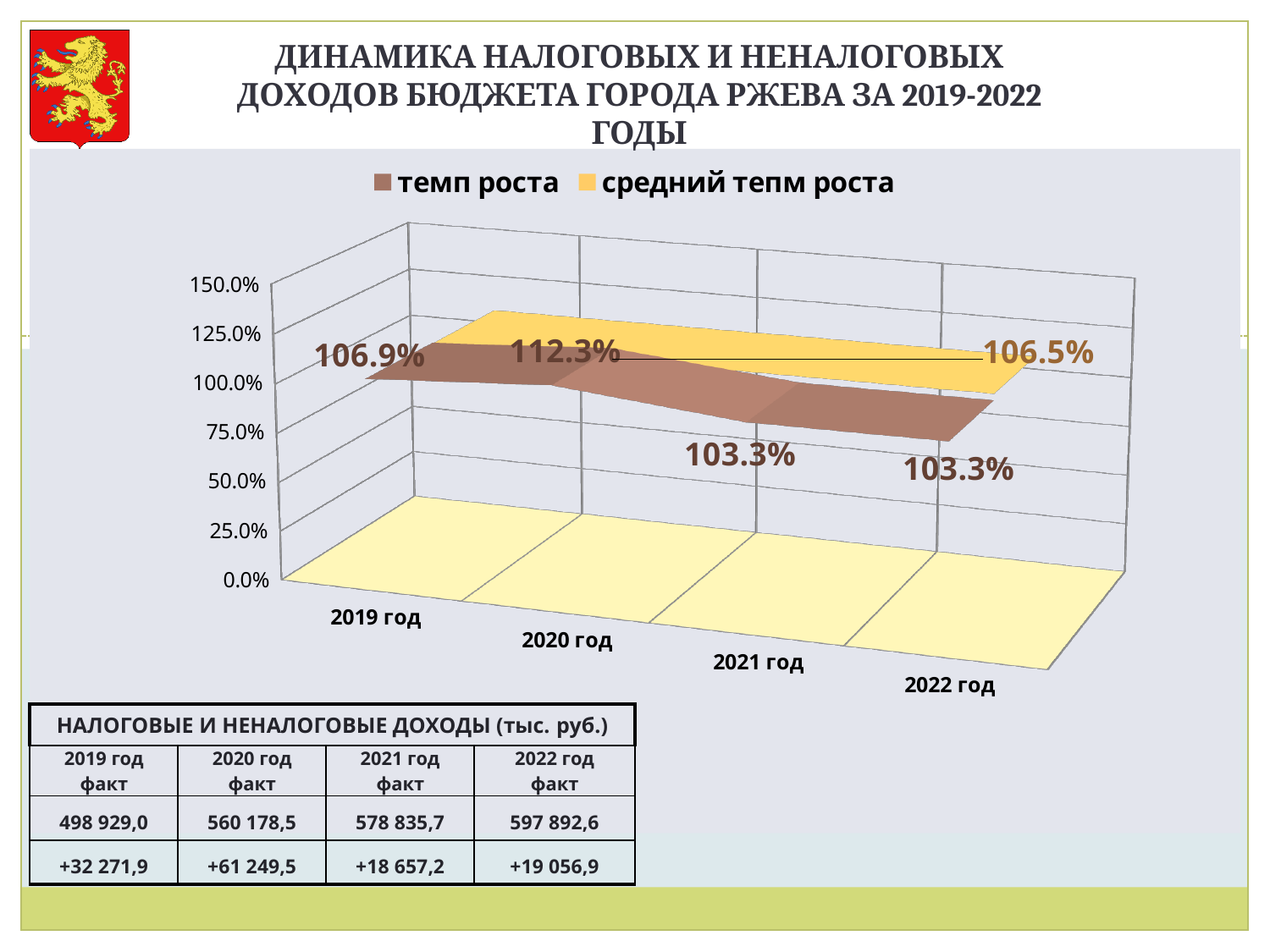
What is the difference between темп роста in 2020 год and 2019 год? 5.4 percentage points How many years are shown on the x axis of the chart? 4 Which is larger, темп роста in 2019 год or in 2020 год? 2020 год In which year is темп роста highest? 2020 год What is the difference between темп роста in 2020 год and 2022 год? 9.0 percentage points What value is labelled for the средний тепм роста series? 106.5% What is the value of темп роста for 2019 год? 106.9% How many series does the chart legend list? 2 What is the value of темп роста for 2021 год? 103.3% Is the value of темп роста for 2022 год greater or less than 100.0%? greater What is the value of темп роста for 2020 год? 112.3% Does темп роста rise or fall from 2020 год to 2022 год? fall